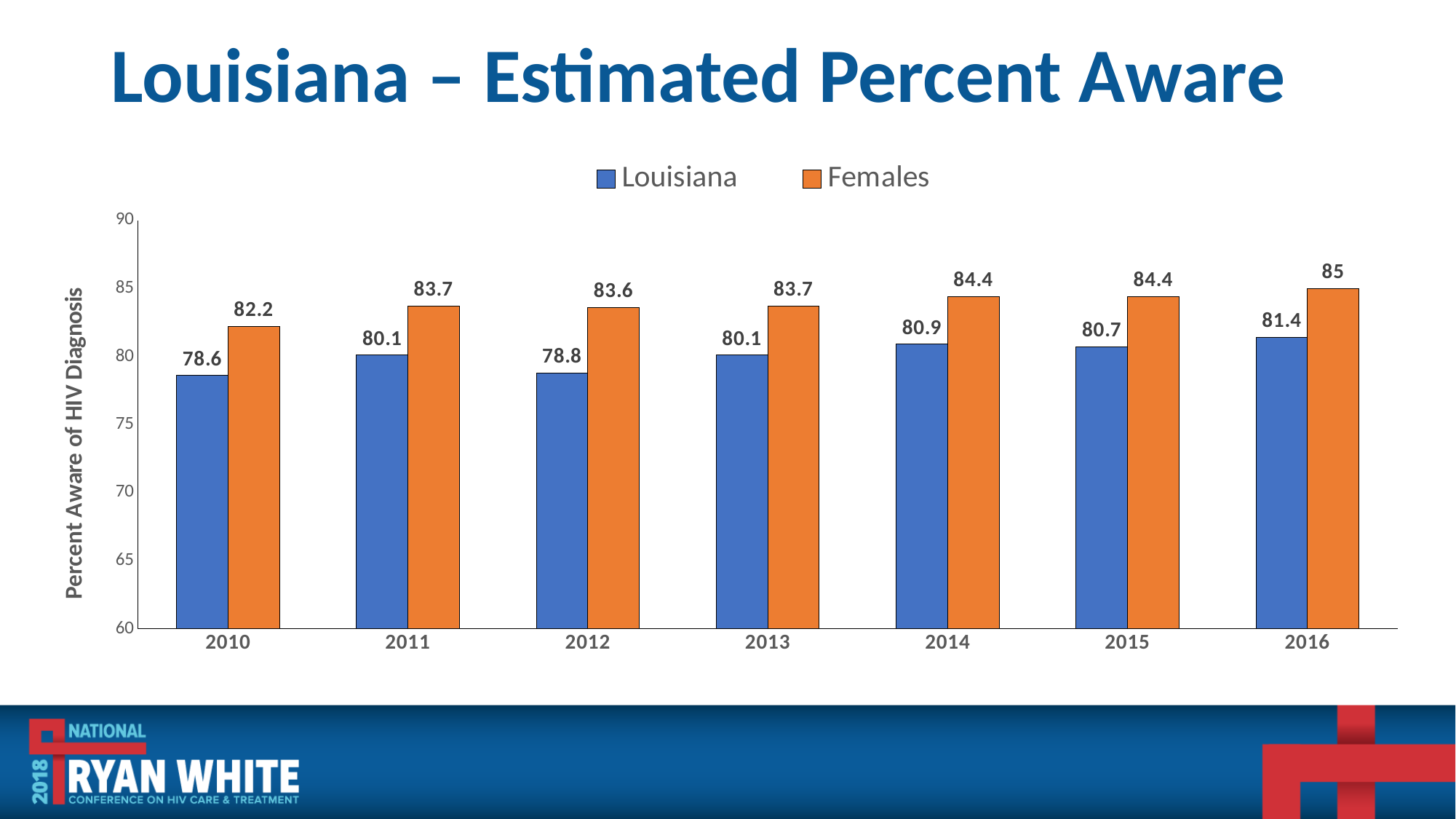
What is the label of the y axis? Percent Aware of HIV Diagnosis How many years are shown on the x axis? 7 What is the Females value for 2016? 85 What kind of chart is shown on the slide? bar chart What is the Females value for 2012? 83.6 What is the difference between the Females and Louisiana values in 2014? 3.5 Which is larger in 2013, the Louisiana value or the Females value? Females How many series does the legend list? 2 What is the Louisiana value for 2010? 78.6 In which year is the Louisiana series lowest? 2010 Is the Louisiana value for 2015 greater or less than 80? greater In which year is the Louisiana series highest? 2016